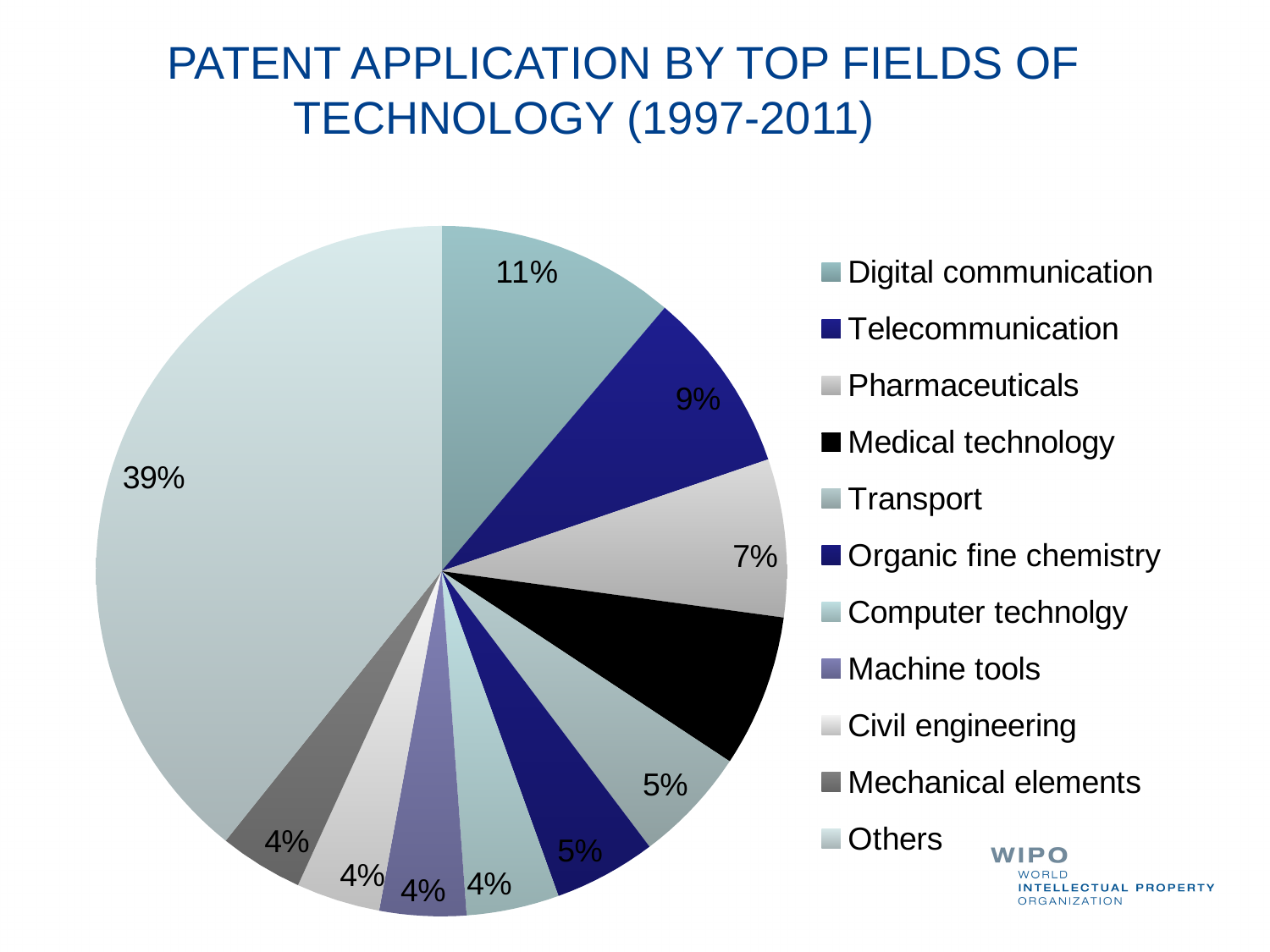
What kind of chart is shown on the slide? Pie chart What percentage does the Others slice represent? 39% Which category has the largest slice of the pie? Others Which is larger, the slice for Pharmaceuticals or the slice for Transport? Pharmaceuticals What percentage is shown for Telecommunication? 9% What is the value shown for Pharmaceuticals? 7% What is the difference in percentage points between Digital communication and Telecommunication? 2 percentage points What share of patent applications is attributed to Digital communication? 11% How many categories does the legend list? 11 What is the value shown for Machine tools? 4% What is the title of the chart? PATENT APPLICATION BY TOP FIELDS OF TECHNOLOGY (1997-2011) What is the difference in percentage points between Others and Digital communication? 28 percentage points